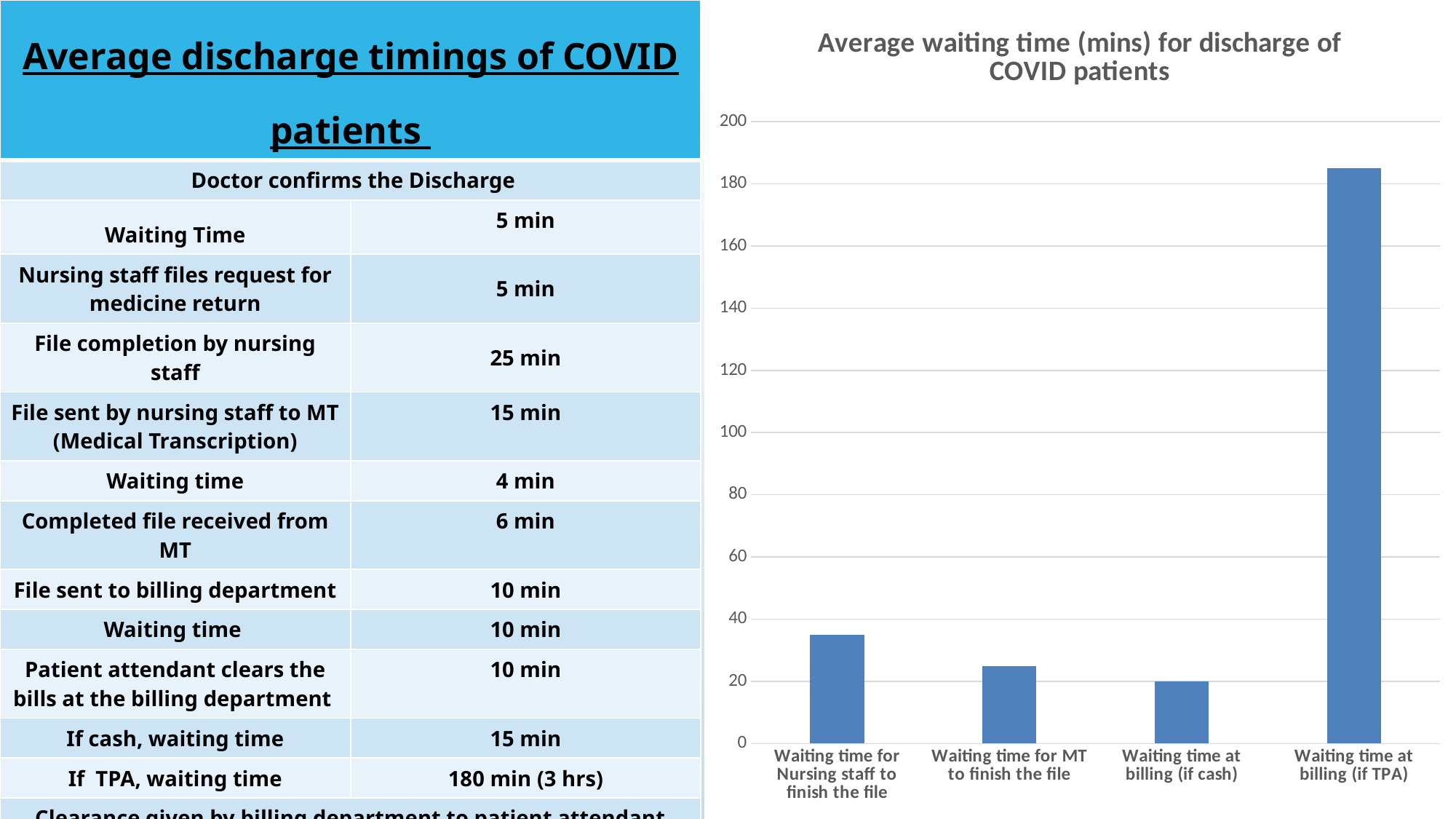
Is the value for Waiting time for MT to finish the file greater or less than 20? greater Which category has the highest average waiting time in the chart? Waiting time at billing (if TPA) What kind of chart is shown on the slide? bar chart What is the title of the chart? Average waiting time (mins) for discharge of COVID patients Which category has the lowest average waiting time in the chart? Waiting time at billing (if cash) Is the value for Waiting time at billing (if TPA) greater or less than 200? less Is the value for Waiting time at billing (if TPA) greater or less than 160? greater How many categories are plotted in the chart? 4 Which is larger: the waiting time for Nursing staff to finish the file or the waiting time for MT to finish the file? Waiting time for Nursing staff to finish the file What is the value for Waiting time at billing (if cash) in the chart? 20 Which is larger: the waiting time at billing (if TPA) or the waiting time at billing (if cash)? Waiting time at billing (if TPA)